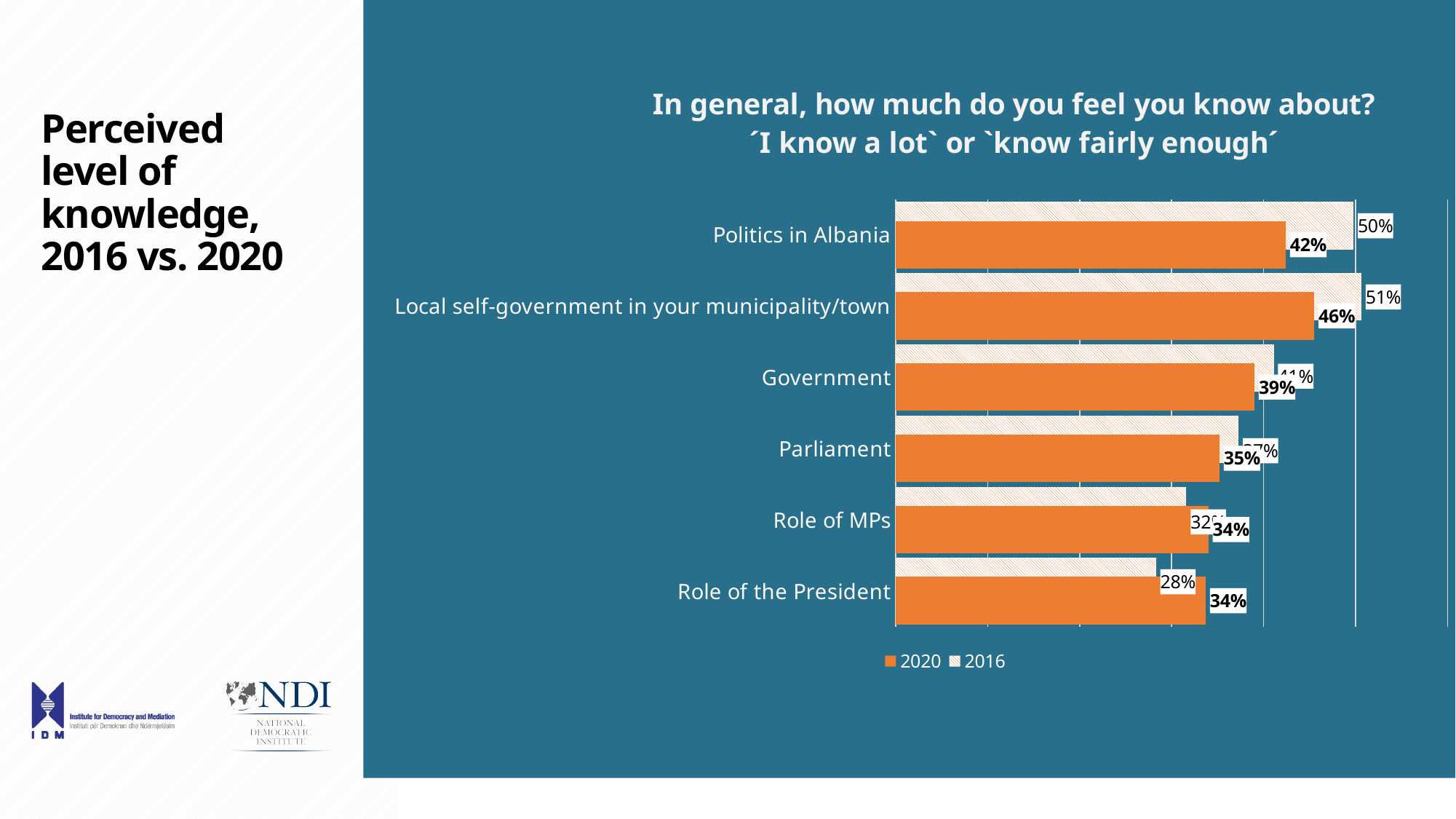
What is the 2016 value for Local self-government in your municipality/town? 51% What is the difference between the 2016 and 2020 values for Politics in Albania? 8 percentage points For Role of the President, which year has the larger value, 2020 or 2016? 2020 What is the 2016 value for Role of the President? 28% What is the 2016 value for Politics in Albania? 50% Which category has the highest 2020 value? Local self-government in your municipality/town How many series does the legend list? 2 What is the 2020 value for Politics in Albania? 42% Which category has the lowest 2016 value? Role of the President How many categories are shown on the chart? 6 What is the 2020 value for Local self-government in your municipality/town? 46% What kind of chart is shown on the slide? Bar chart